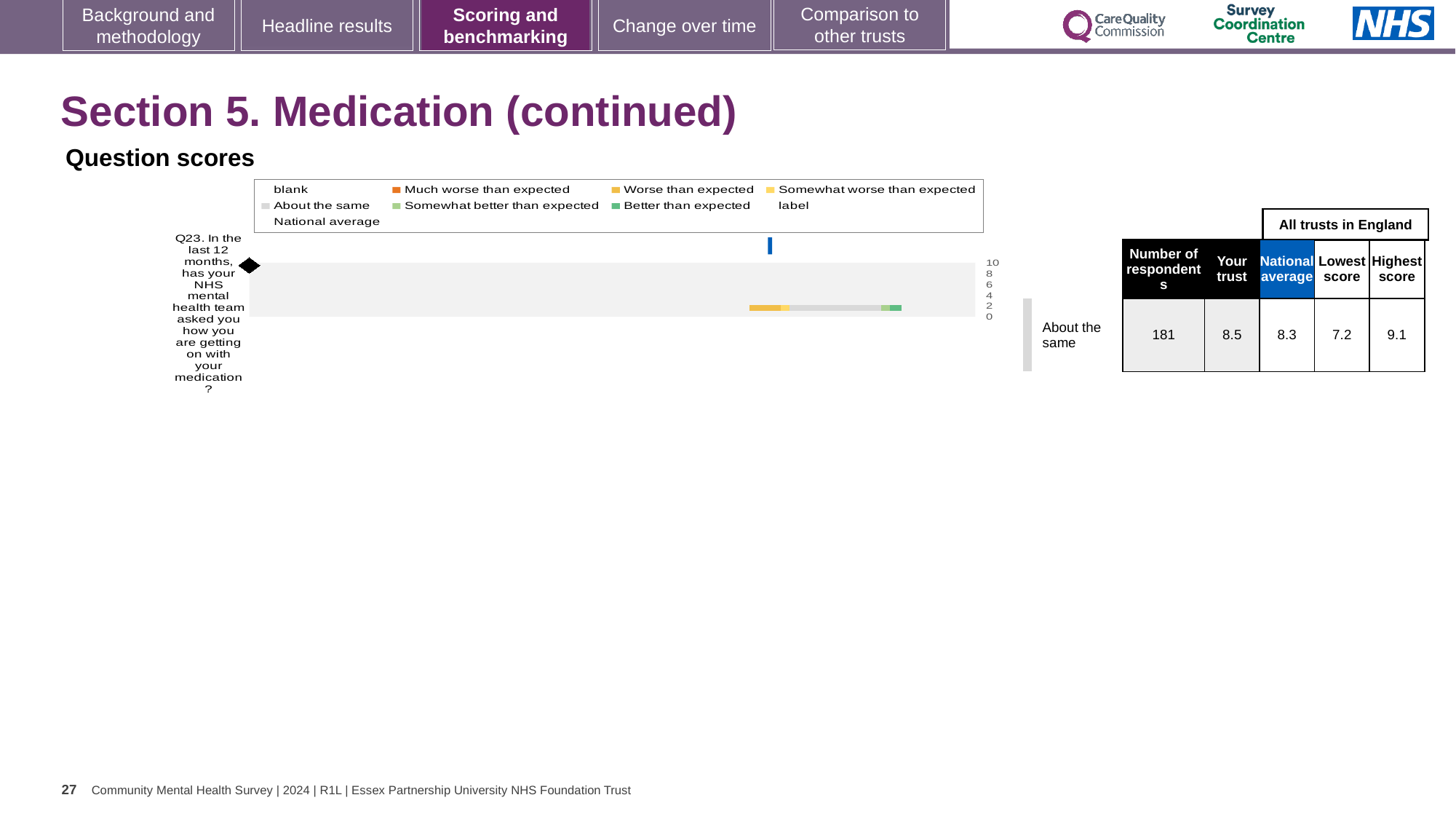
What kind of chart is shown on the slide? bar chart According to the table next to the chart, what is the lowest score among all trusts in England for Q23? 7.2 Which is larger for Q23: the 'Your trust' score or the national average? Your trust Which question is plotted on the chart? Q23. In the last 12 months, has your NHS mental health team asked you how you are getting on with your medication? What is the difference between the 'Your trust' score and the national average for Q23? 0.2 What is the maximum value shown on the chart's score axis? 10 How many respondents answered Q23, according to the table next to the chart? 181 How many questions (categories) are plotted on the chart? 1 According to the table next to the chart, what is the highest score among all trusts in England for Q23? 9.1 Which benchmark category is the trust's Q23 score placed in, as labelled beside the chart? About the same According to the table next to the chart, what is the national average score for Q23? 8.3 According to the table next to the chart, what is the 'Your trust' score for Q23? 8.5